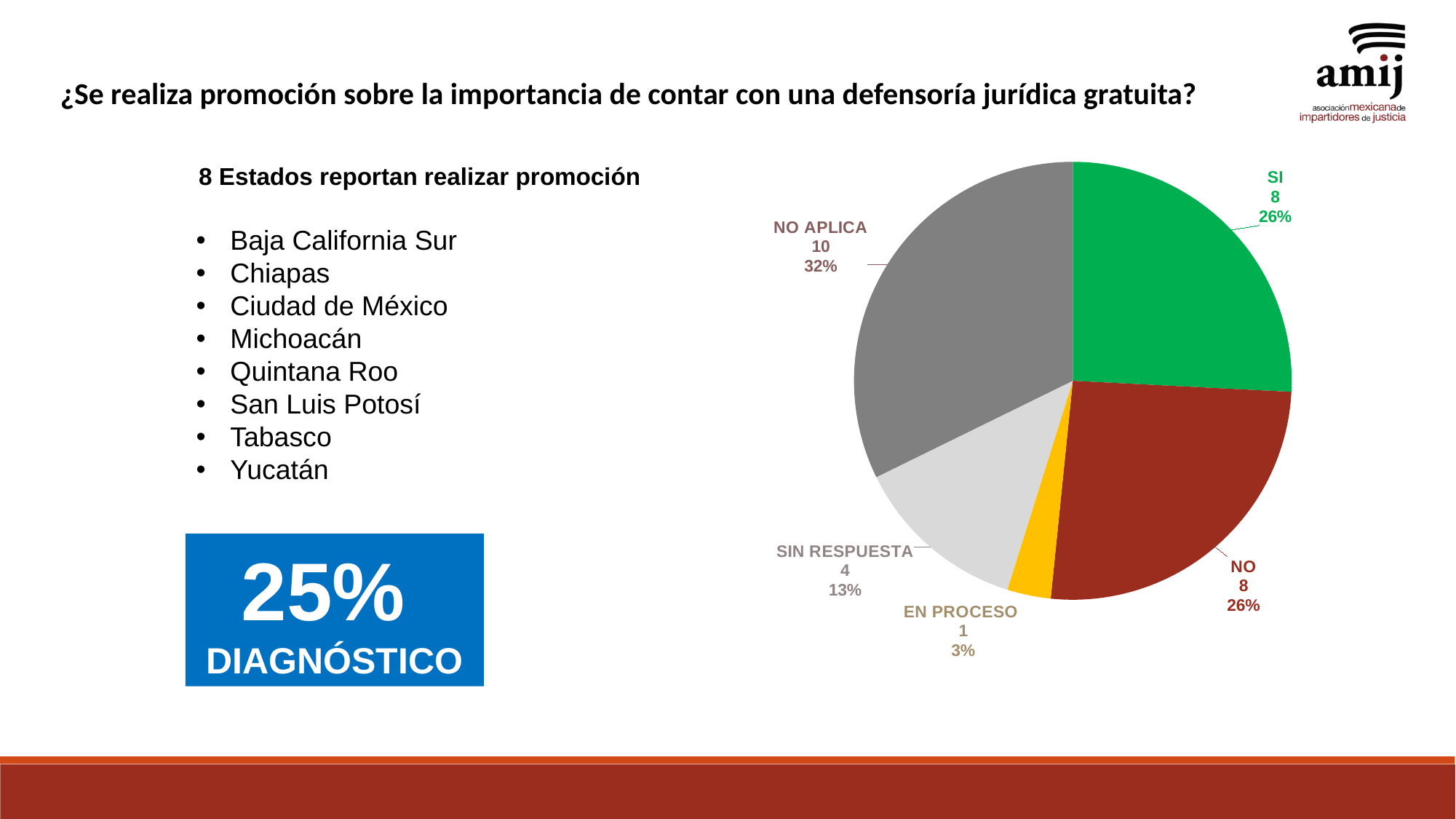
What is the count for the NO APLICA slice? 10 What percentage share does the SI slice represent? 26% What is the difference between the NO APLICA count and the SIN RESPUESTA count? 6 What percentage share does the SIN RESPUESTA slice represent? 13% What is the total of all the counts shown in the pie chart? 31 Which is larger, the SIN RESPUESTA count or the EN PROCESO count? SIN RESPUESTA What is the count for the EN PROCESO slice? 1 Which category has the smallest slice in the pie chart? EN PROCESO How many slices does the pie chart have? 5 Which category has the largest slice in the pie chart? NO APLICA What kind of chart is shown on the slide? pie chart What colour is the NO slice in the pie chart? dark red